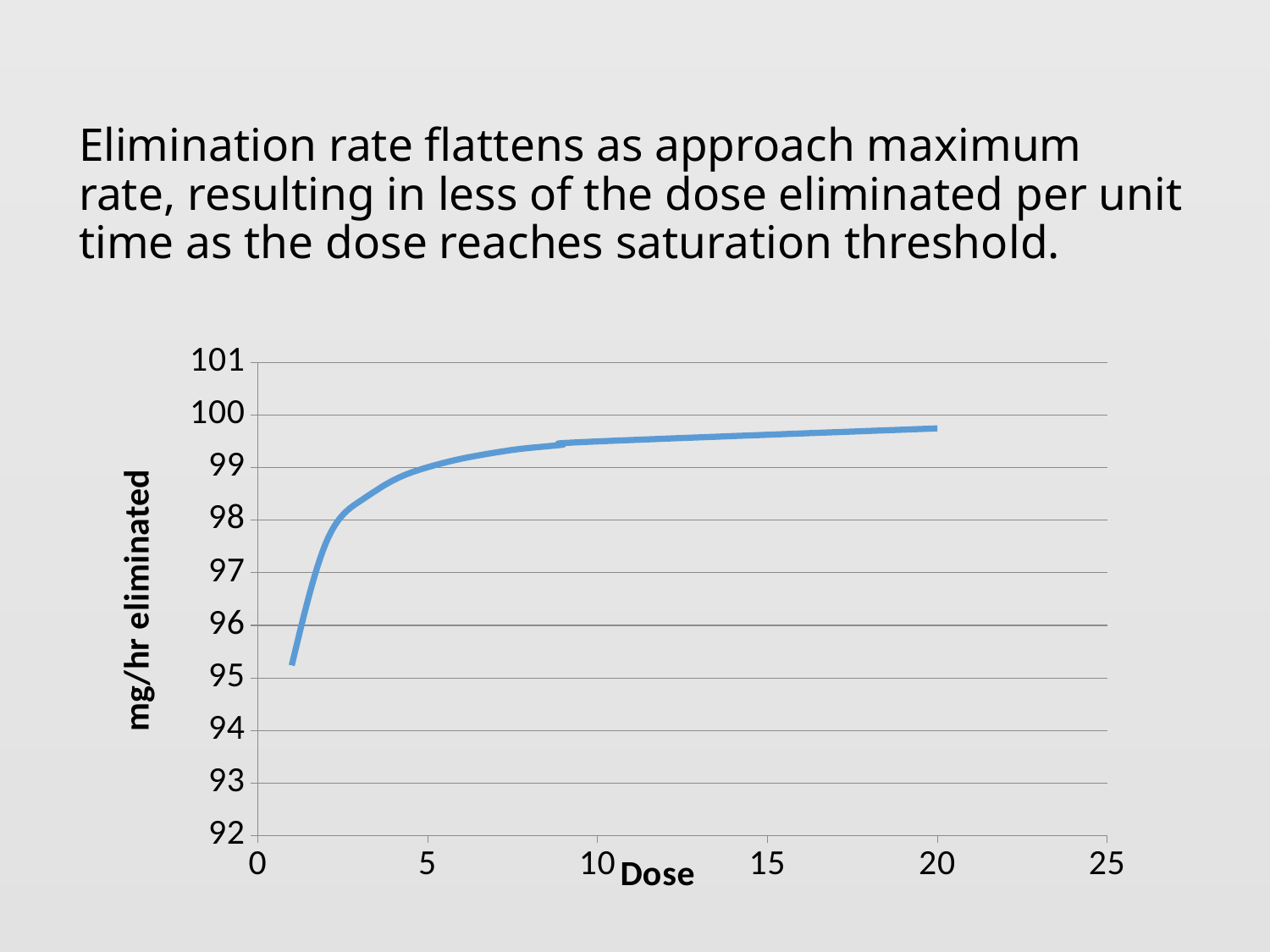
Is the value for mg/hr eliminated at a dose of 10 greater or less than 100? less What is the label of the x axis? Dose Do the values rise or fall as the dose increases along the x axis? rise What is the label of the y axis? mg/hr eliminated Is the value for mg/hr eliminated at a dose of 1 greater or less than 96? less Which has the smaller mg/hr eliminated value, a dose of 1 or a dose of 20? a dose of 1 Is the value for mg/hr eliminated at a dose of 5 greater or less than 98? greater Which has the larger mg/hr eliminated value, a dose of 2 or a dose of 15? a dose of 15 What is the highest value shown on the y axis? 101 What kind of chart is shown on the slide? line chart